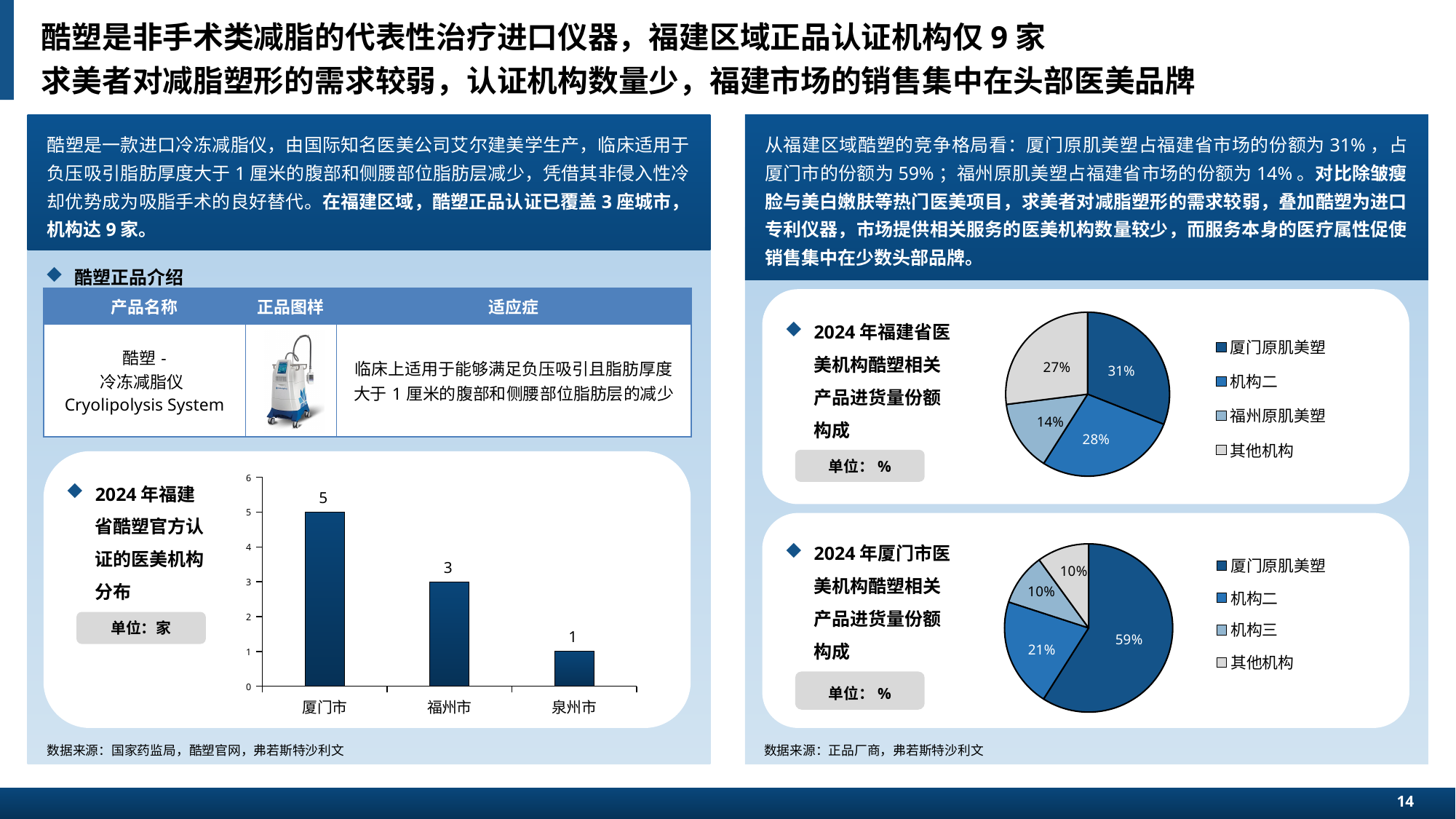
In the pie chart '2024年福建省医美机构酷塑相关产品进货量份额构成', what share does 福州原肌美塑 hold? 14% In the pie chart '2024年福建省医美机构酷塑相关产品进货量份额构成', how many entries does the legend list? 4 In the pie chart '2024年厦门市医美机构酷塑相关产品进货量份额构成', what share does 厦门原肌美塑 hold? 59% In the bar chart '2024年福建省酷塑官方认证的医美机构分布', how many certified institutions are in 厦门市? 5 In the bar chart '2024年福建省酷塑官方认证的医美机构分布', which city has the fewest certified institutions? 泉州市 In the pie chart '2024年厦门市医美机构酷塑相关产品进货量份额构成', which is larger, the share of 机构二 or the share of 机构三? 机构二 In the bar chart '2024年福建省酷塑官方认证的医美机构分布', what is the difference between the values for 厦门市 and 福州市? 2 In the pie chart '2024年厦门市医美机构酷塑相关产品进货量份额构成', what is the difference between the shares of 厦门原肌美塑 and 机构二? 38% In the pie chart '2024年福建省医美机构酷塑相关产品进货量份额构成', which institution has the largest share? 厦门原肌美塑 What type of chart is '2024年福建省酷塑官方认证的医美机构分布'? bar chart In the bar chart '2024年福建省酷塑官方认证的医美机构分布', how many cities are shown? 3 In the bar chart '2024年福建省酷塑官方认证的医美机构分布', do the values rise or fall from 厦门市 to 泉州市? fall